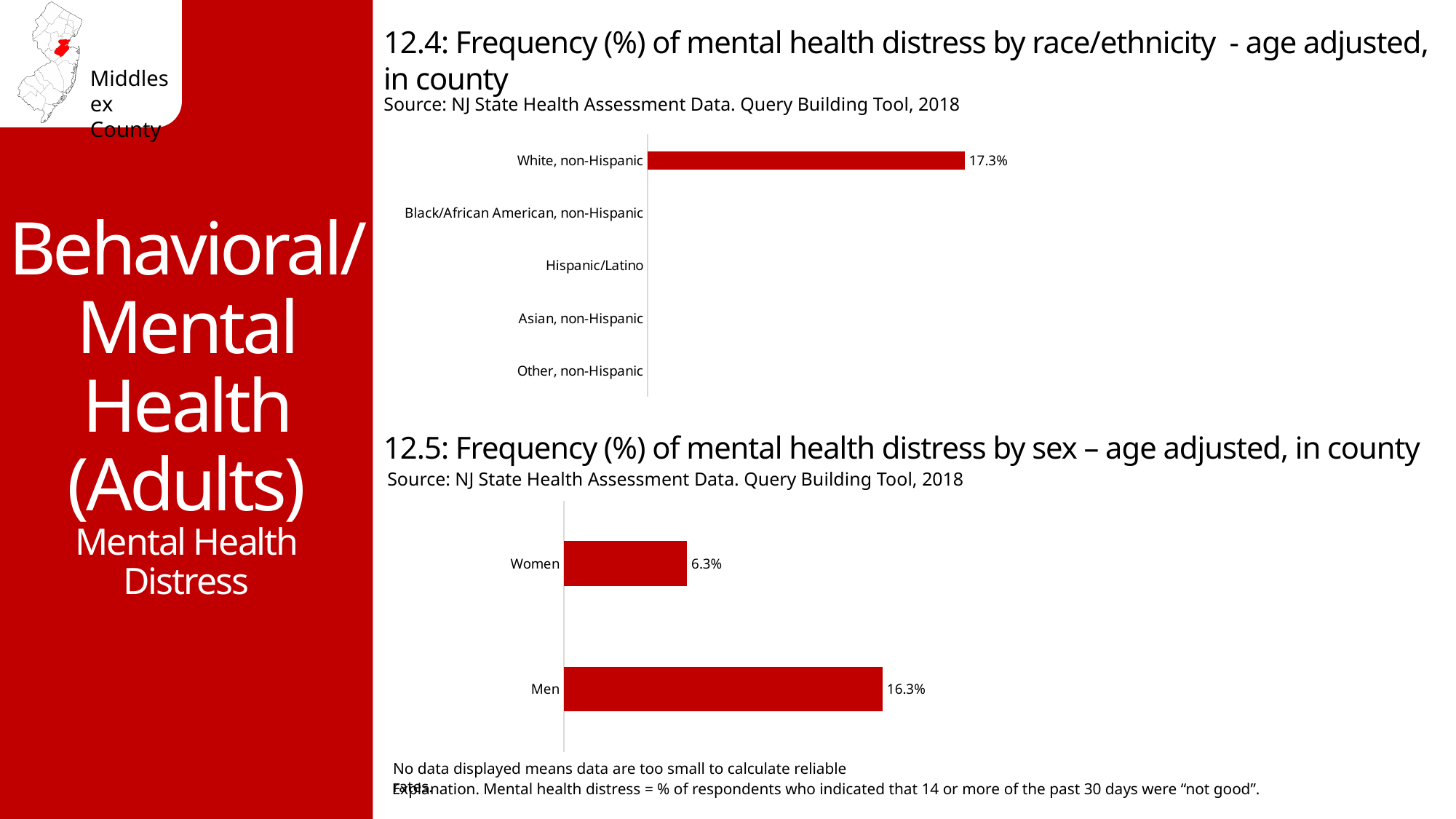
In the chart '12.5: Frequency (%) of mental health distress by sex – age adjusted, in county', what is the value for Men? 16.3% In the chart '12.4: Frequency (%) of mental health distress by race/ethnicity - age adjusted, in county', what is the value for White, non-Hispanic? 17.3% What kind of chart is '12.4: Frequency (%) of mental health distress by race/ethnicity - age adjusted, in county'? Bar chart In the chart '12.5: Frequency (%) of mental health distress by sex – age adjusted, in county', how many categories are shown? 2 What source is cited for the chart '12.5: Frequency (%) of mental health distress by sex – age adjusted, in county'? NJ State Health Assessment Data. Query Building Tool, 2018 What kind of chart is '12.5: Frequency (%) of mental health distress by sex – age adjusted, in county'? Bar chart In the chart '12.5: Frequency (%) of mental health distress by sex – age adjusted, in county', which category has the higher value? Men In the chart '12.4: Frequency (%) of mental health distress by race/ethnicity - age adjusted, in county', which category is the only one with a bar displayed? White, non-Hispanic In the chart '12.5: Frequency (%) of mental health distress by sex – age adjusted, in county', what is the difference between the values for Men and Women? 10 percentage points In the chart '12.4: Frequency (%) of mental health distress by race/ethnicity - age adjusted, in county', how many race/ethnicity categories are listed on the axis? 5 In the chart '12.5: Frequency (%) of mental health distress by sex – age adjusted, in county', which category has the lower value? Women In the chart '12.5: Frequency (%) of mental health distress by sex – age adjusted, in county', what is the value for Women? 6.3%